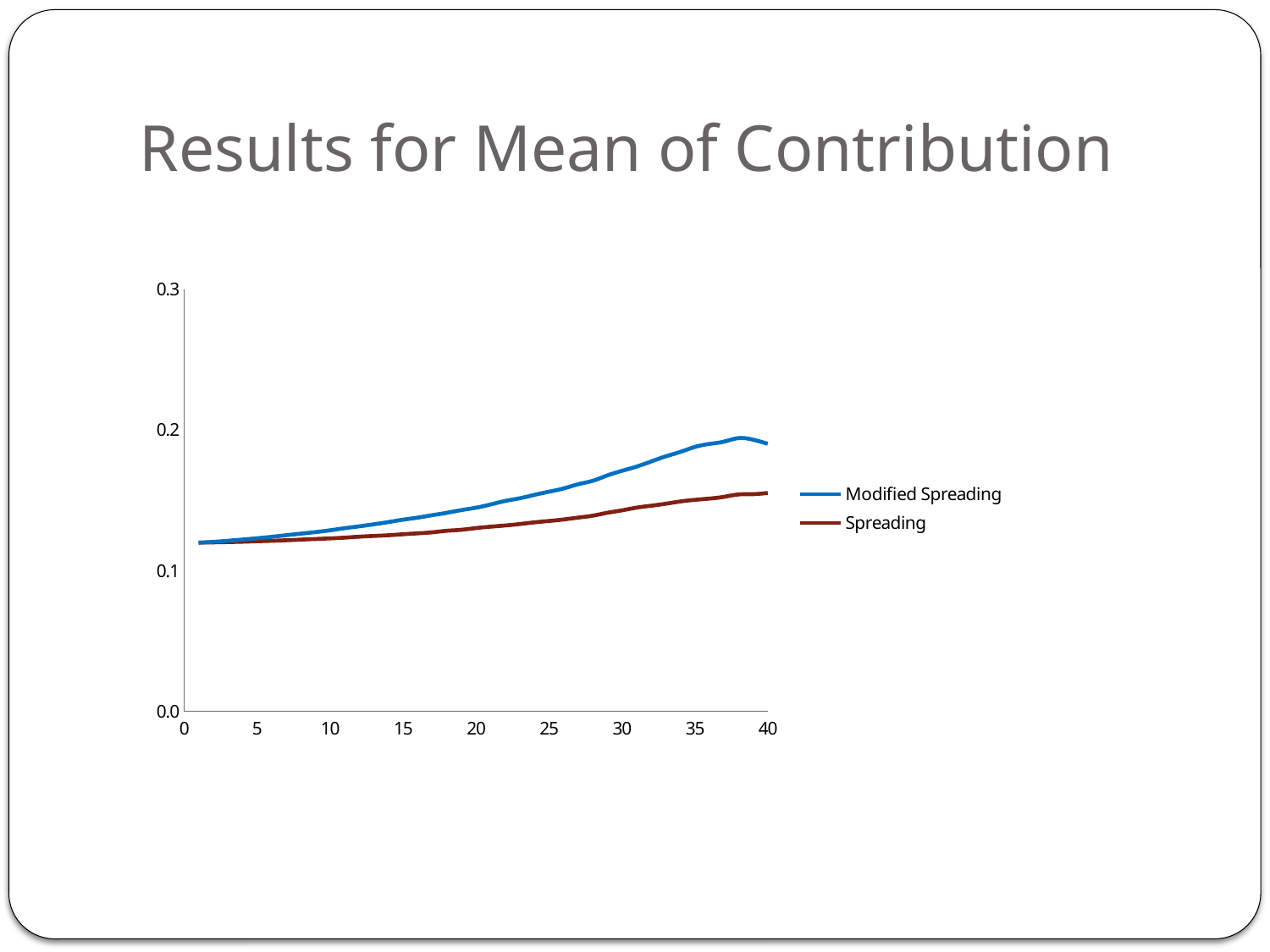
What kind of chart is shown on the slide? line chart Which series reaches the higher value at the right end of the x axis (40)? Modified Spreading Which series has the lower values across the whole x axis range? Spreading Is the value for Modified Spreading at x = 30 greater or less than 0.3? less Do the values for Modified Spreading generally rise or fall as the x axis goes from 0 to 40? rise Is the value for Spreading at x = 5 greater or less than 0.2? less Is the value for Spreading at x = 40 greater or less than 0.2? less How many series does the legend list? 2 Do the values for Spreading rise or fall along the x axis? rise Which series is plotted with the blue line? Modified Spreading What is the title of the slide containing the chart? Results for Mean of Contribution